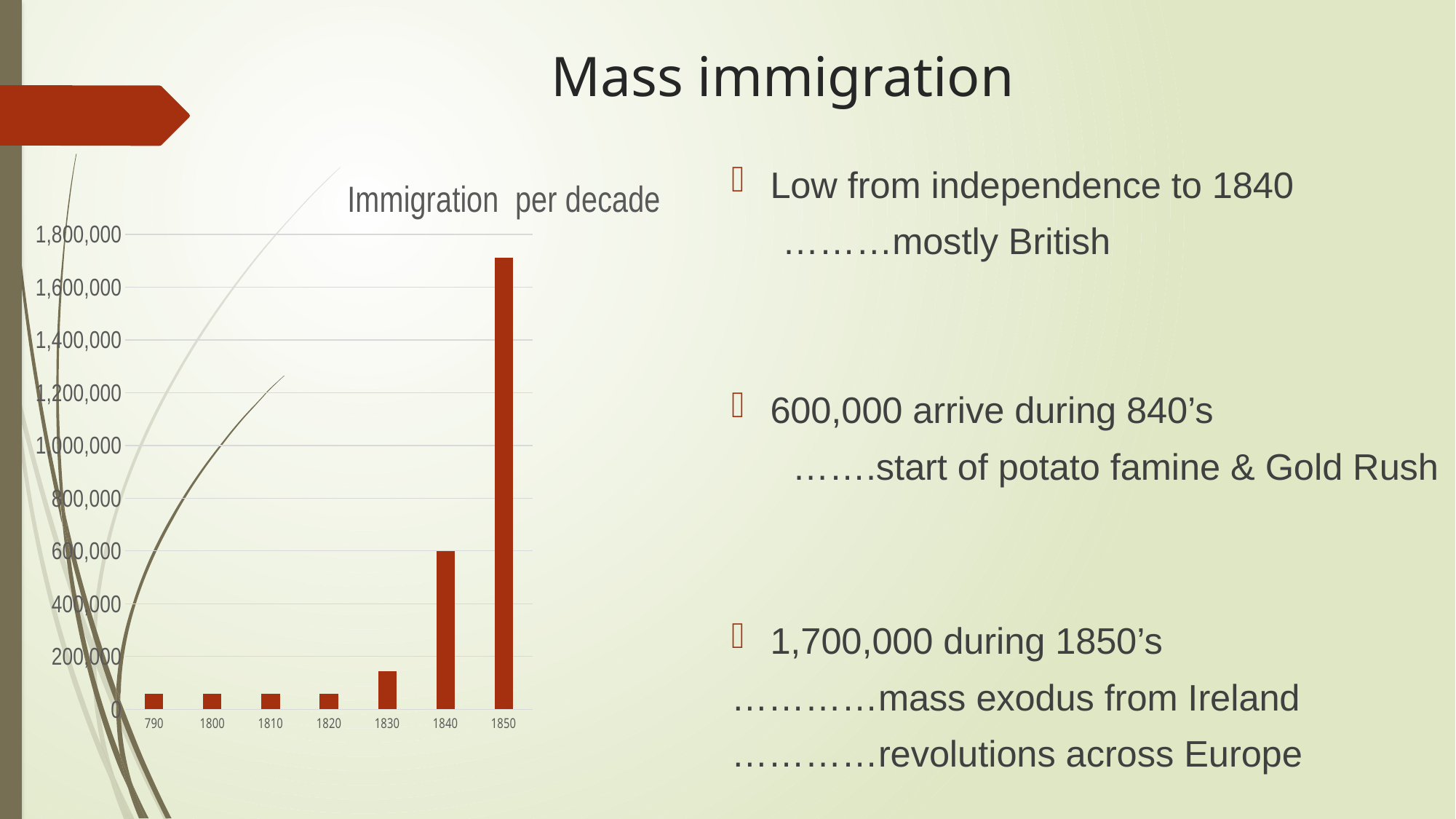
Do the values generally rise or fall from 1820 to 1850 along the x axis? rise Which is larger, the value for 1840 or the value for 1850? 1850 How many bars (decades) are plotted in the chart? 7 Is the value for 1830 greater or less than 200,000? less Is the value for 1850 greater or less than 1,600,000? greater Which is larger, the value for 1820 or the value for 1830? 1830 What is the highest value shown on the vertical axis of the chart? 1,800,000 Is the value for 1850 greater or less than 1,800,000? less Which decade has the highest immigration in the chart? 1850 What kind of chart is shown on the slide? bar chart What is the title of the chart? Immigration per decade